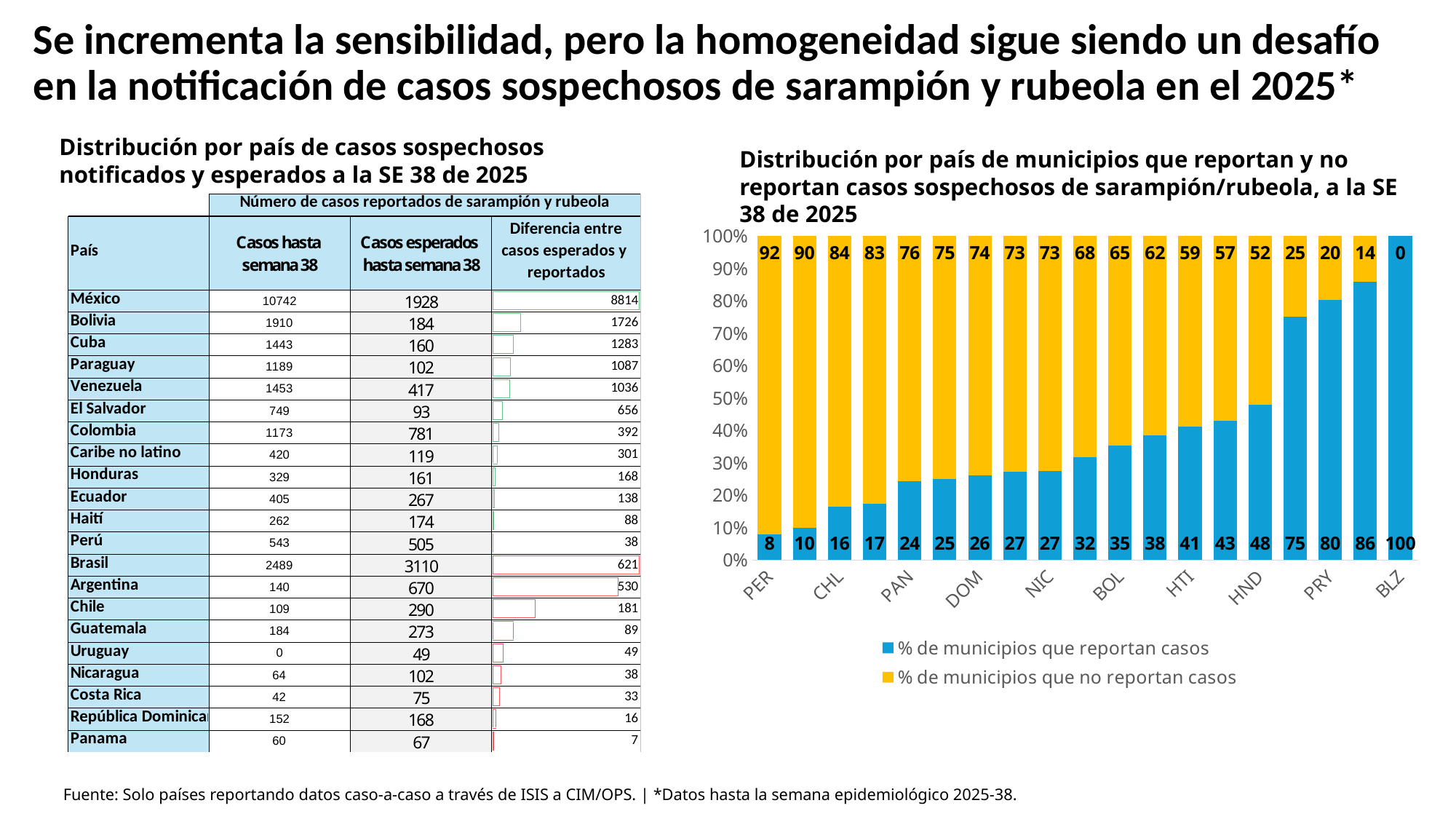
In the bar chart, what is the % de municipios que reportan casos for HND? 48 In the bar chart, what is the % de municipios que no reportan casos for PRY? 20 In the bar chart, what is the difference between the % de municipios que reportan casos for HND and for PAN? 24 In the bar chart, which colour represents % de municipios que reportan casos? Blue In the bar chart, which labelled country has the highest % de municipios que reportan casos? BLZ In the bar chart, what is the % de municipios que reportan casos for PER? 8 How many series does the legend of the bar chart list? 2 How many bars (countries) are plotted in the bar chart? 19 In the bar chart, do the values for % de municipios que reportan casos rise or fall from left to right along the x axis? Rise In the bar chart, which has a larger % de municipios que reportan casos, CHL or BOL? BOL In the bar chart, which labelled country has the lowest % de municipios que reportan casos? PER What type of chart is shown on the right side of the slide? Stacked bar chart